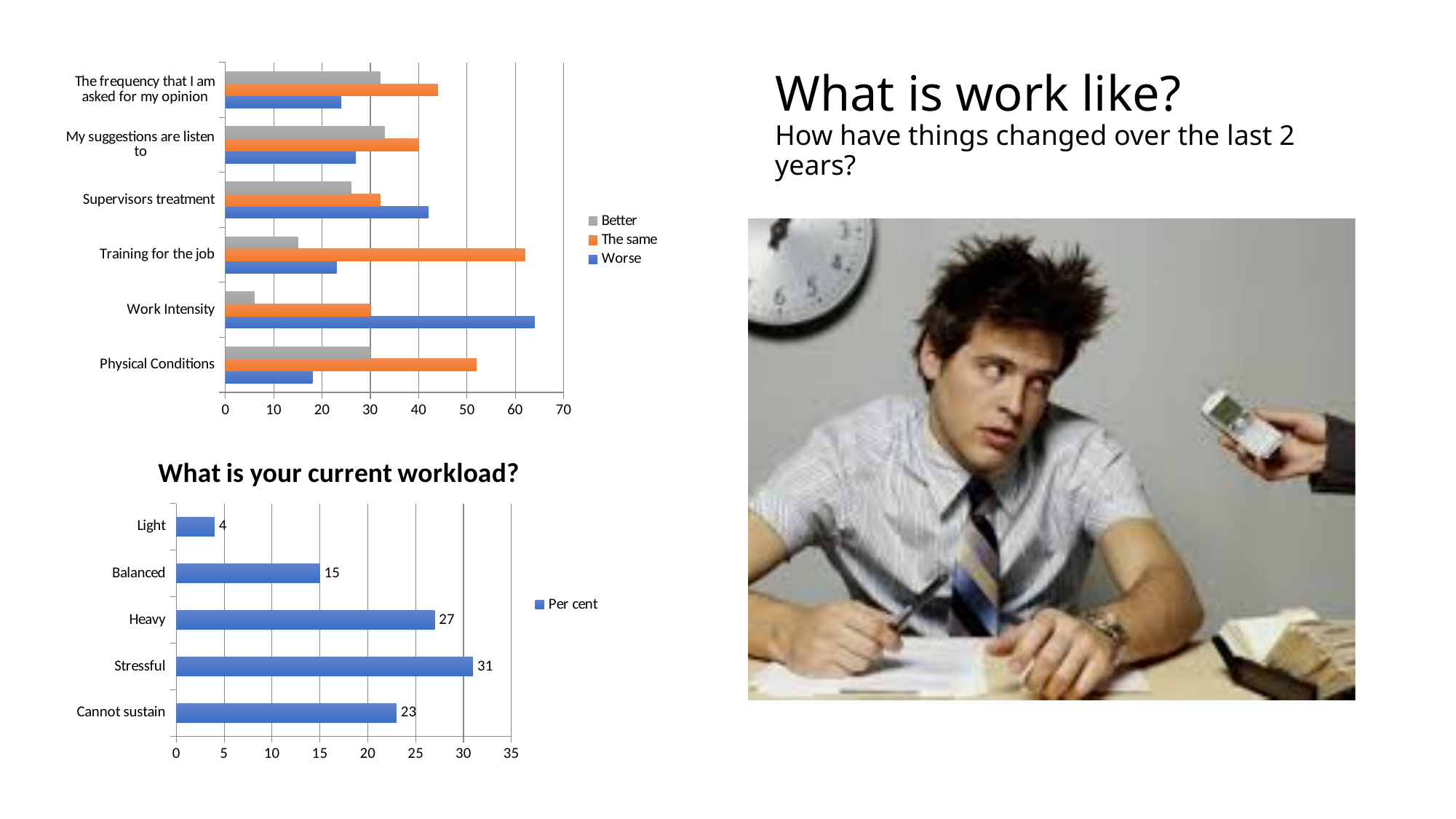
In the chart titled 'What is your current workload?', what is the difference between the values for Heavy and Balanced? 12 In the chart titled 'What is your current workload?', which is larger, the value for Cannot sustain or the value for Balanced? Cannot sustain In the chart titled 'What is your current workload?', which category has the lowest value? Light In the chart titled 'What is your current workload?', what is the value for Stressful? 31 In the top-left chart, which is larger for Training for the job, the 'The same' bar or the 'Better' bar? The same In the top-left chart, is the 'Worse' value for Work Intensity greater or less than 60? greater In the top-left chart, is the 'Better' value for Work Intensity greater or less than 10? less What kind of chart is the top-left chart? Bar chart In the top-left chart, how many series does the legend list? 3 In the chart titled 'What is your current workload?', how many categories are shown? 5 In the chart titled 'What is your current workload?', which category has the highest value? Stressful In the chart titled 'What is your current workload?', what is the value for Light? 4